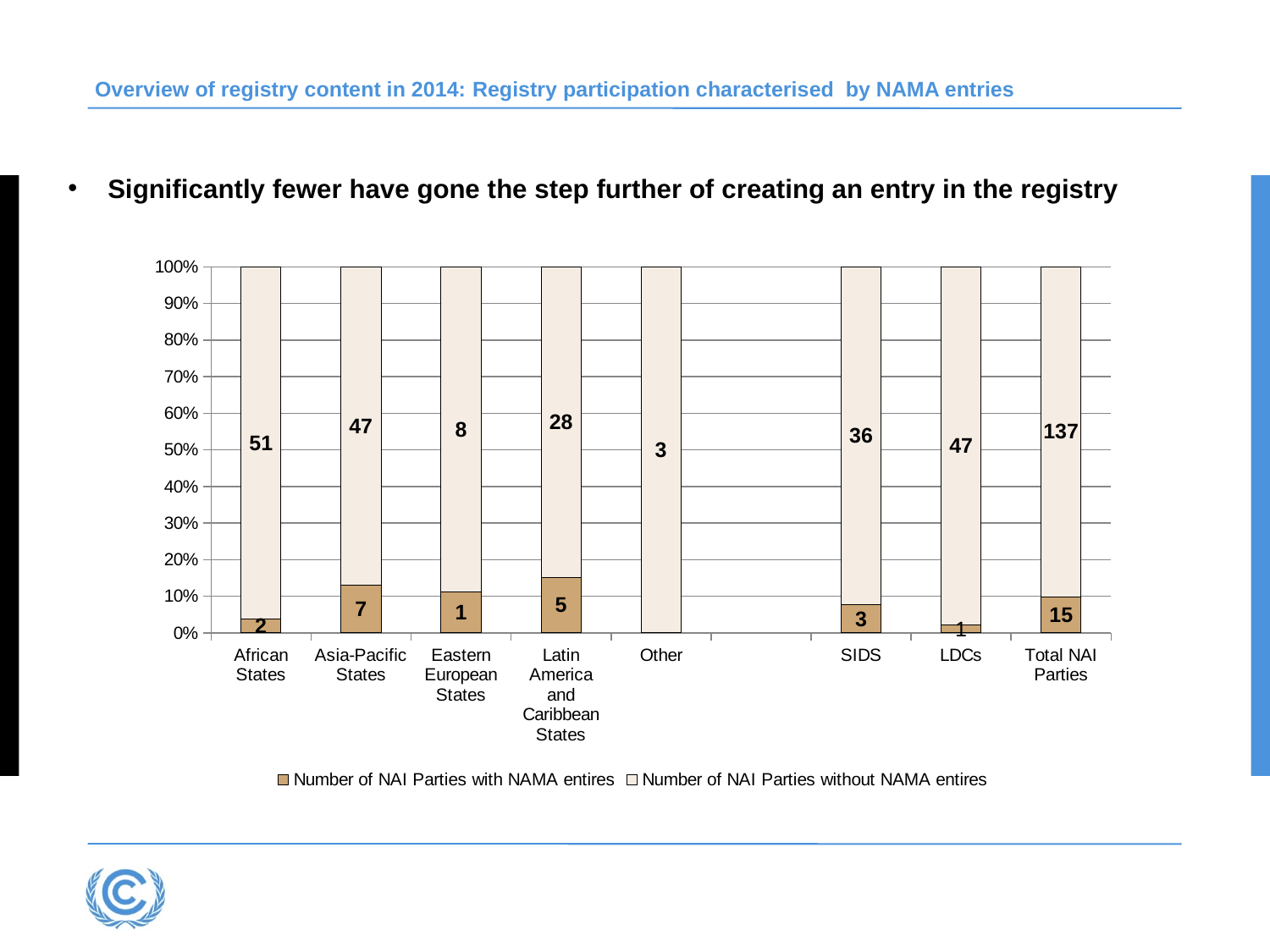
What is the difference between the number of NAI Parties without NAMA entries for Asia-Pacific States and for Latin America and Caribbean States? 19 What is the number of NAI Parties without NAMA entries for SIDS? 36 Which category has the lowest number of NAI Parties without NAMA entries? Other What is the number of NAI Parties with NAMA entries for Total NAI Parties? 15 How many series does the legend list? 2 What is the total number of NAI Parties (with and without NAMA entries) for African States? 53 What is the number of NAI Parties without NAMA entries for African States? 51 Is the share of NAI Parties with NAMA entries for LDCs greater or less than 10%? less What is the number of NAI Parties with NAMA entries for Asia-Pacific States? 7 What kind of chart is shown on the slide? Stacked bar chart Which has more NAI Parties with NAMA entries, Latin America and Caribbean States or SIDS? Latin America and Caribbean States Which category has the highest number of NAI Parties without NAMA entries? Total NAI Parties